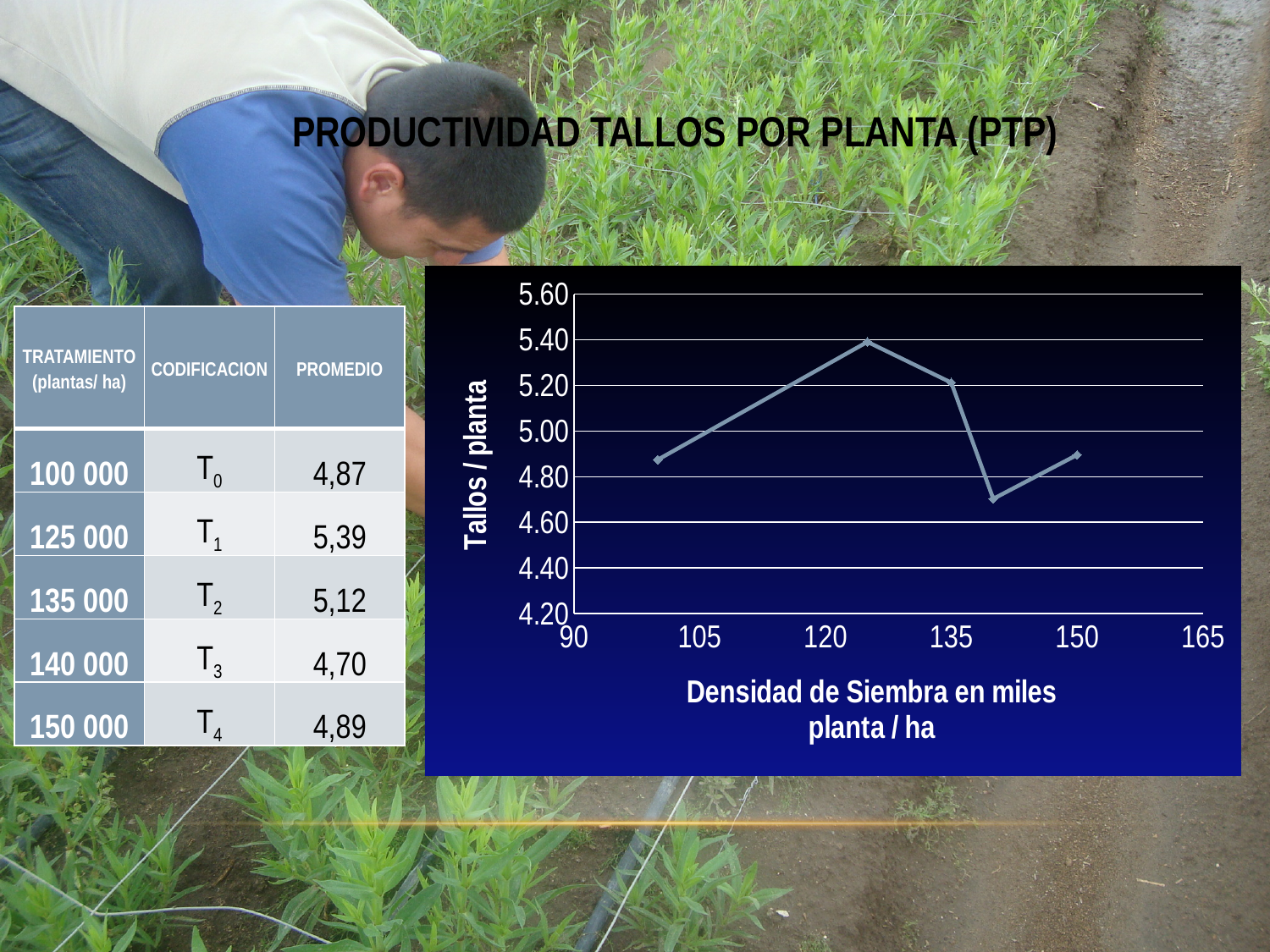
Is the value at density 135 greater or less than 5.00? greater At which planting density (x-axis value) does the line chart reach its highest value? 125 What kind of chart is shown on the slide? line chart Which has the higher value on the line chart, density 125 or density 135? 125 Is the value at density 140 greater or less than 4.80? less Is the value at density 125 greater or less than 5.20? greater Does the line rise or fall between density 125 and density 140? fall How many data points are plotted on the line chart? 5 What is the title of the x axis of the chart? Densidad de Siembra en miles planta / ha At which planting density (x-axis value) does the line chart reach its lowest value? 140 What is the title of the y axis of the chart? Tallos / planta